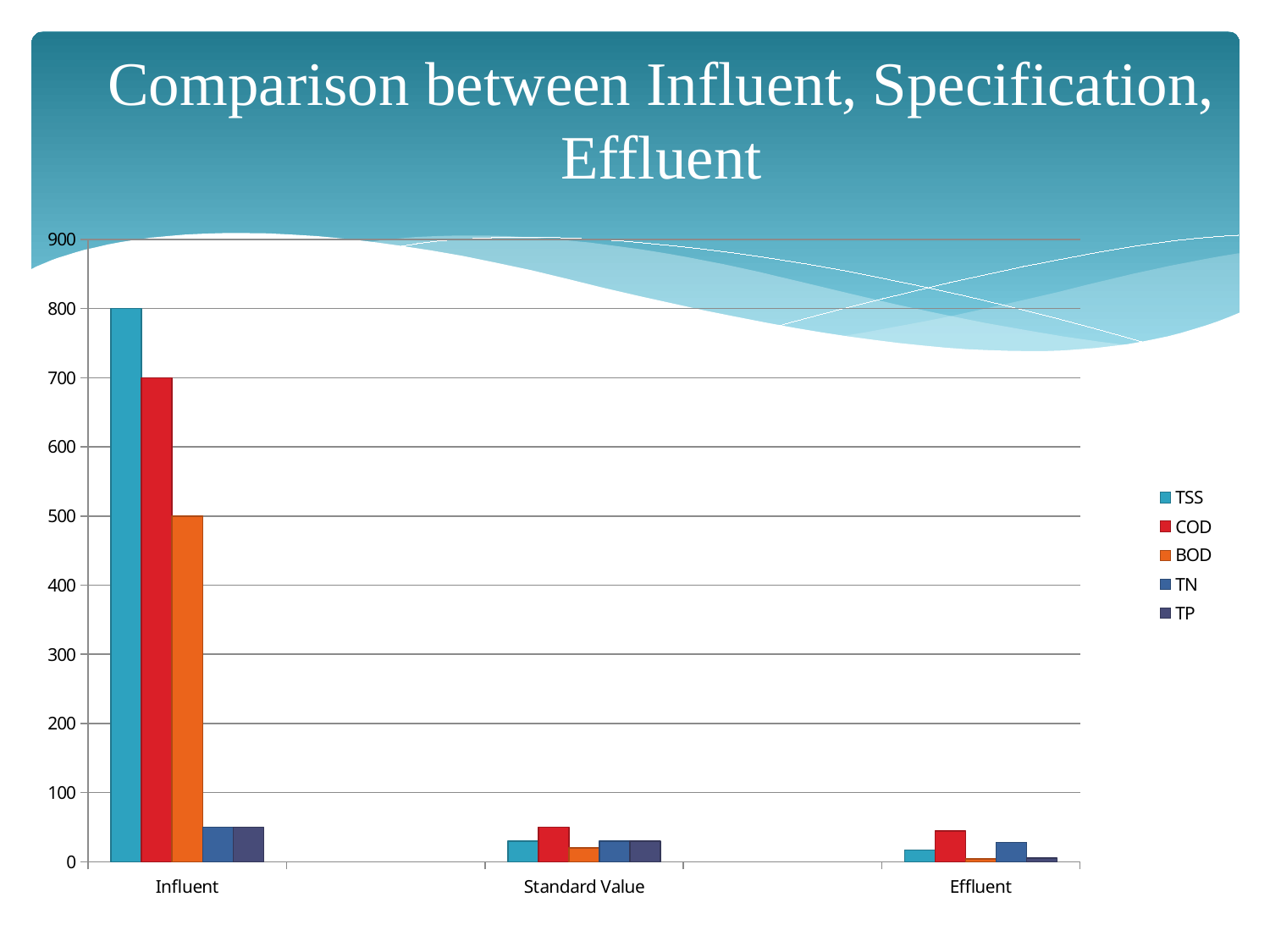
What is the difference between the COD and BOD values for Influent? 200 Is the COD value for Effluent greater or less than 100? less What is the BOD value for Influent? 500 For Effluent, which is larger, the COD value or the TSS value? COD What is the TSS value for Influent? 800 What is the difference between the TSS and COD values for Influent? 100 Which series has the highest value for Influent? TSS What is the COD value for Influent? 700 How many categories are shown on the x axis? 3 Is the TN value for Influent greater or less than 100? less What type of chart is shown on the slide? bar chart How many series does the legend list? 5